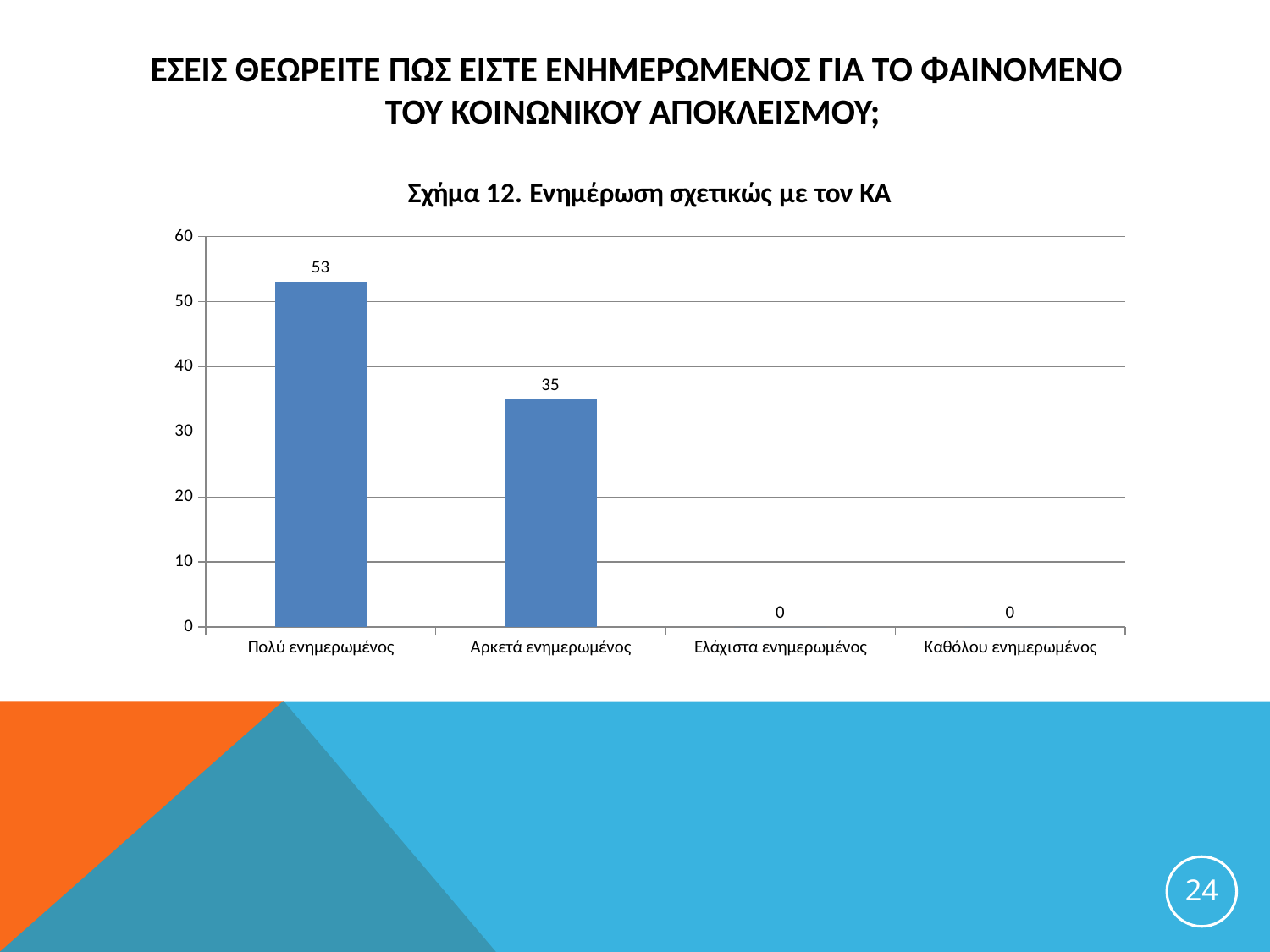
What is the value for Καθόλου ενημερωμένος? 0 What is the difference between the values for Πολύ ενημερωμένος and Αρκετά ενημερωμένος? 18 What is the title of the chart? Σχήμα 12. Ενημέρωση σχετικώς με τον ΚΑ What is the value for Ελάχιστα ενημερωμένος? 0 Is the value for Αρκετά ενημερωμένος greater or less than 40? less Is the value for Πολύ ενημερωμένος greater or less than 50? greater What is the value for Αρκετά ενημερωμένος? 35 What is the value for Πολύ ενημερωμένος? 53 Which is larger, the value for Πολύ ενημερωμένος or the value for Αρκετά ενημερωμένος? Πολύ ενημερωμένος Which category has the highest value? Πολύ ενημερωμένος How many categories are shown on the x axis? 4 What kind of chart is shown on the slide? bar chart